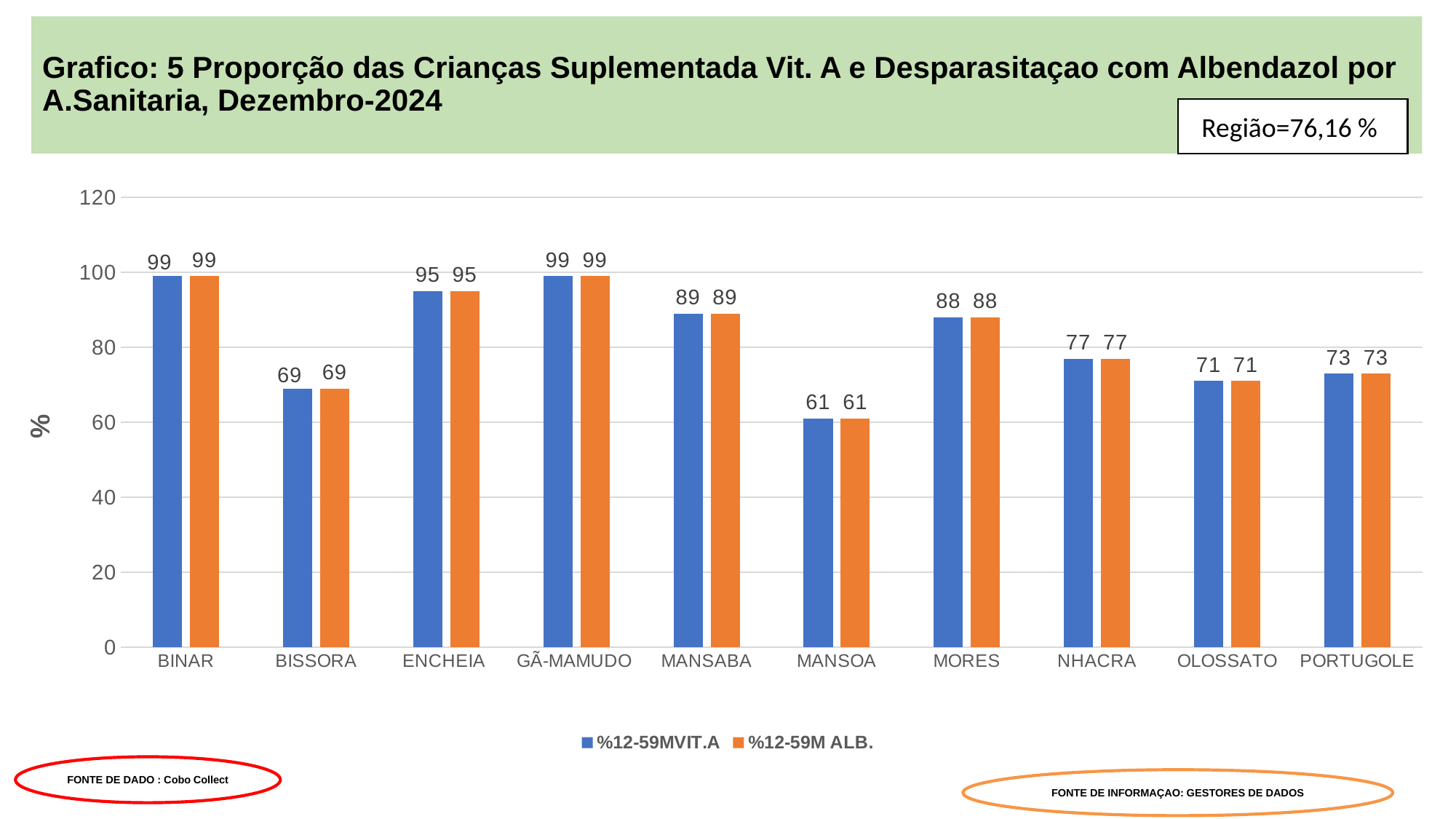
How many areas (categories) are shown on the x axis? 10 Is the value for %12-59M ALB. in MANSOA greater or less than 80? less What kind of chart is shown on the slide? bar chart What is the value for %12-59MVIT.A in OLOSSATO? 71 How many series does the legend list? 2 What is the value for %12-59M ALB. in NHACRA? 77 What is the difference between the %12-59M ALB. values for MORES and PORTUGOLE? 15 What regional value is shown in the box at the top right of the slide? Região=76,16 % What is the value for %12-59MVIT.A in MANSABA? 89 Which area has the lowest value for %12-59M ALB.? MANSOA What is the difference between the %12-59MVIT.A values for ENCHEIA and BISSORA? 26 Which is larger, the %12-59MVIT.A value for MANSABA or for NHACRA? MANSABA